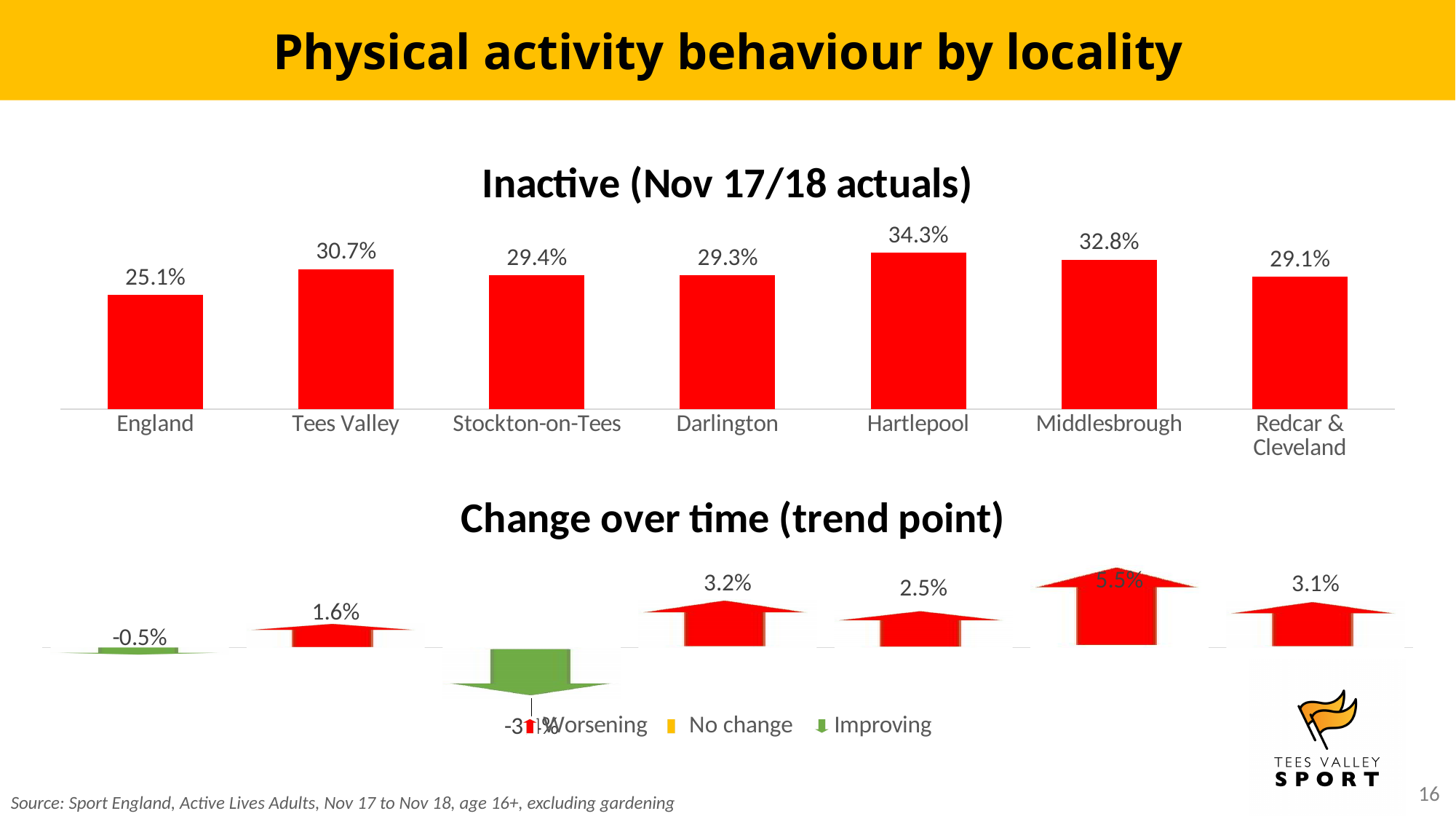
In the 'Inactive (Nov 17/18 actuals)' chart, what is the difference between Tees Valley and England? 5.6% What type of chart is 'Inactive (Nov 17/18 actuals)'? Bar chart In the 'Inactive (Nov 17/18 actuals)' chart, which category has the lowest value? England In the 'Change over time (trend point)' chart, what is the value for Middlesbrough? 5.5% In the 'Inactive (Nov 17/18 actuals)' chart, what is the value for Hartlepool? 34.3% How many entries does the legend of the 'Change over time (trend point)' chart list? 3 In the 'Inactive (Nov 17/18 actuals)' chart, which locality has the highest inactive percentage? Hartlepool In the 'Inactive (Nov 17/18 actuals)' chart, which is larger, Middlesbrough or Redcar & Cleveland? Middlesbrough How many categories are shown in the 'Inactive (Nov 17/18 actuals)' chart? 7 In the 'Change over time (trend point)' chart, what is the value for England? -0.5% In the 'Inactive (Nov 17/18 actuals)' chart, what is the value for England? 25.1% In the 'Change over time (trend point)' chart, what is the difference between Darlington (3.2%) and Hartlepool (2.5%)? 0.7%